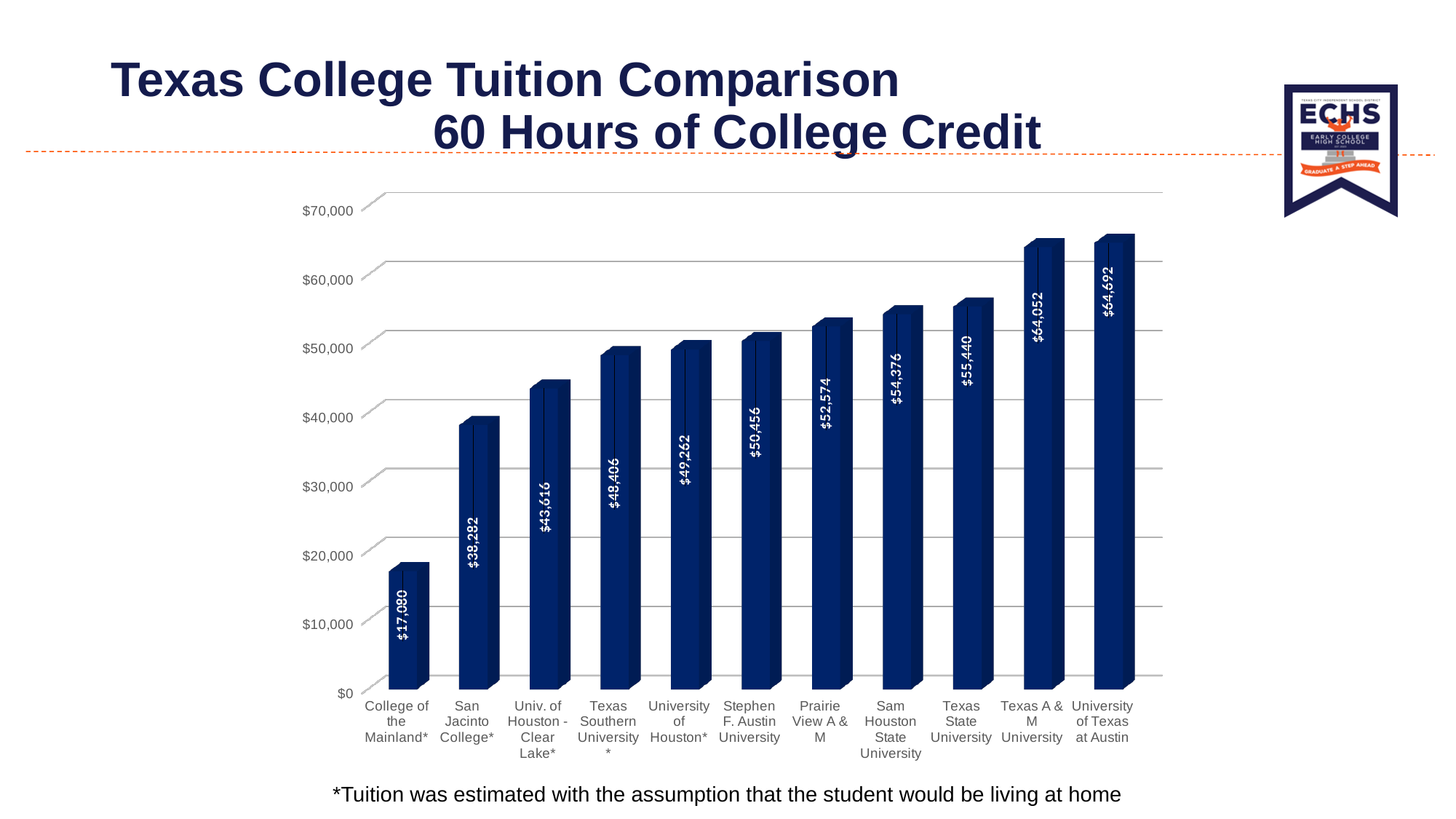
Do the tuition values rise or fall from left to right across the chart? rise What kind of chart is shown on the slide? bar chart What is the tuition value shown for Prairie View A & M? $52,574 Which has the higher tuition, Sam Houston State University or Stephen F. Austin University? Sam Houston State University What is the tuition value shown for Texas State University? $55,440 Which college has the lowest tuition on the chart? College of the Mainland* What is the tuition value shown for University of Texas at Austin? $64,692 What is the difference in tuition between San Jacinto College* and College of the Mainland*? $21,202 What is the tuition value shown for College of the Mainland*? $17,080 How many colleges are shown on the chart? 11 Is the tuition for Univ. of Houston - Clear Lake* greater or less than $40,000? greater Which college has the highest tuition on the chart? University of Texas at Austin